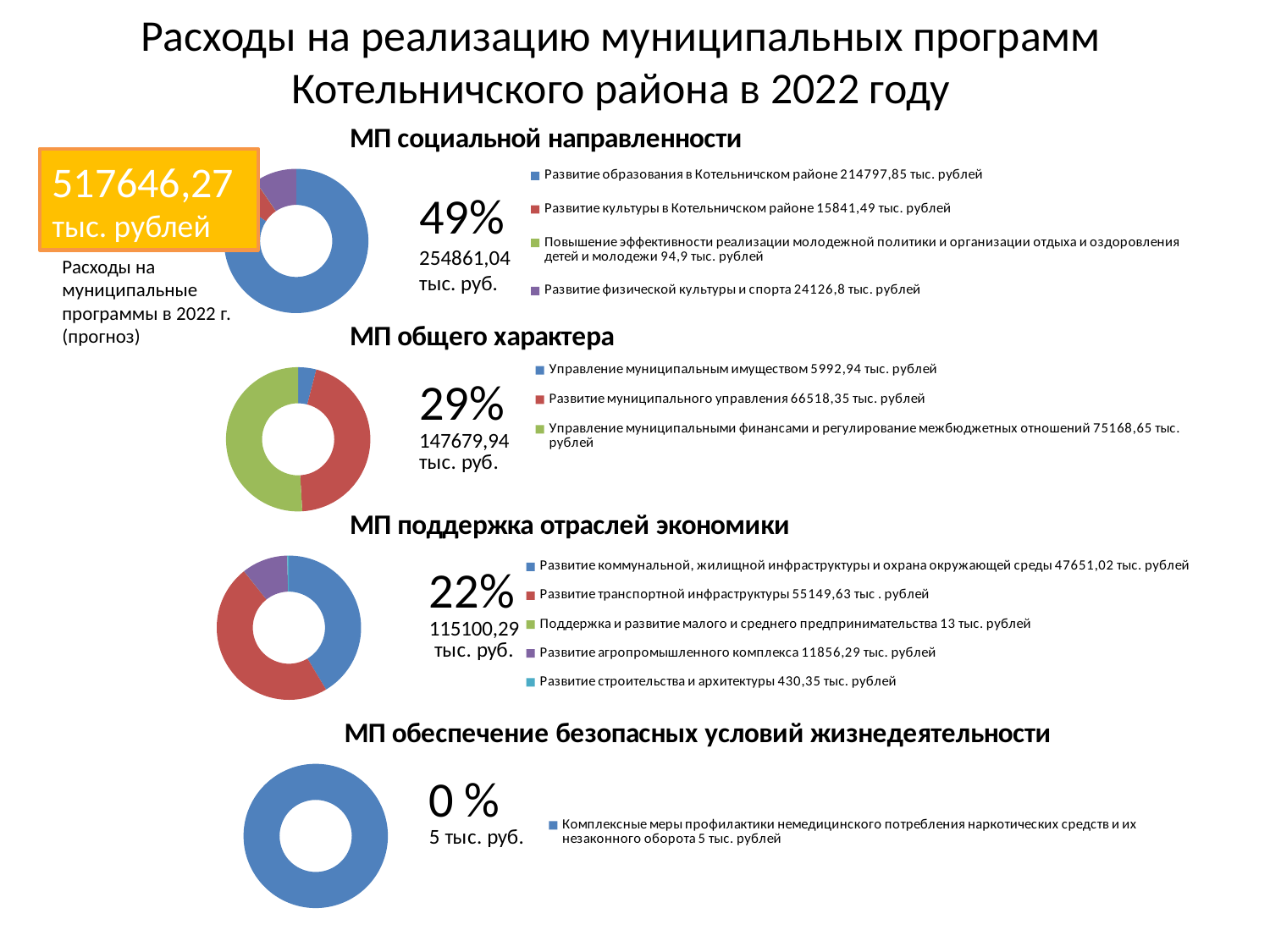
In the chart 'МП общего характера', which category has the highest value? Управление муниципальными финансами и регулирование межбюджетных отношений What share of total expenditures is shown next to the chart 'МП социальной направленности'? 49% How many categories does the legend of the chart 'МП общего характера' list? 3 How many categories does the legend of the chart 'МП поддержка отраслей экономики' list? 5 What total amount is shown next to the chart 'МП общего характера'? 147679,94 тыс. руб. What is the value for 'Комплексные меры профилактики немедицинского потребления наркотических средств и их незаконного оборота' in the chart 'МП обеспечение безопасных условий жизнедеятельности'? 5 тыс. рублей In the chart 'МП социальной направленности', which category has the lowest value? Повышение эффективности реализации молодежной политики и организации отдыха и оздоровления детей и молодежи In the chart 'МП поддержка отраслей экономики', what is the value for 'Развитие агропромышленного комплекса'? 11856,29 тыс. рублей In the chart 'МП поддержка отраслей экономики', which is larger: 'Развитие транспортной инфраструктуры' or 'Развитие коммунальной, жилищной инфраструктуры и охрана окружающей среды'? Развитие транспортной инфраструктуры In the chart 'МП общего характера', what is the difference between 'Управление муниципальными финансами и регулирование межбюджетных отношений' and 'Развитие муниципального управления'? 8650,3 тыс. рублей What kind of chart is used for 'МП обеспечение безопасных условий жизнедеятельности'? doughnut chart In the chart 'МП социальной направленности', what is the value for 'Развитие образования в Котельничском районе'? 214797,85 тыс. рублей